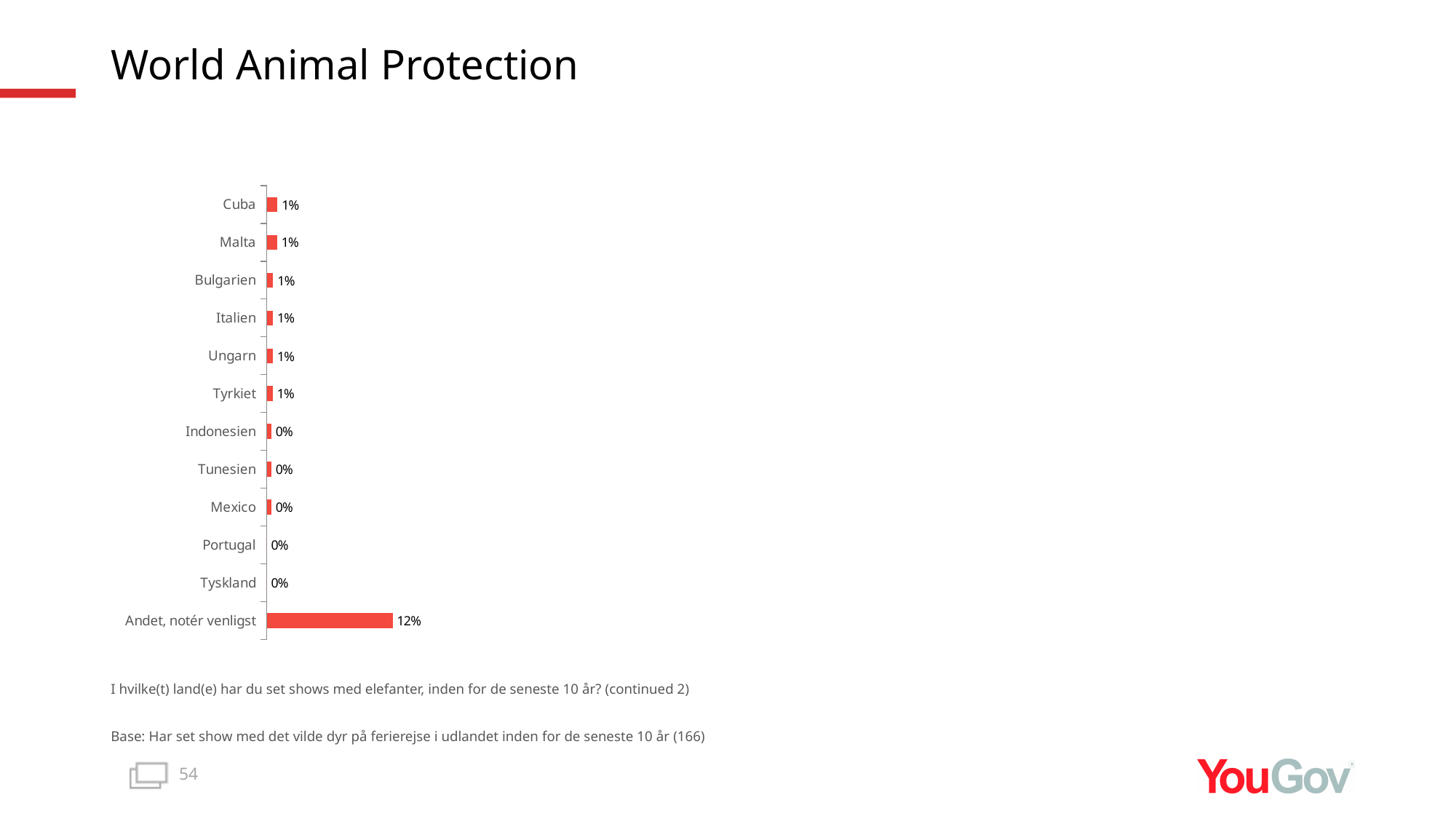
What is the value for Ungarn? 1% What is the value for Indonesien? 0% What is the value for Andet, notér venligst? 12% What colour are the bars in the chart? Red What is the difference between the values for Andet, notér venligst and Malta? 11% Which is larger, the value for Andet, notér venligst or the value for Tyrkiet? Andet, notér venligst What kind of chart is shown on the slide? Bar chart How many categories are shown in the chart? 12 Which category has the highest value? Andet, notér venligst What is the value for Tyskland? 0% What is the value for Cuba? 1% What is the value for Portugal? 0%